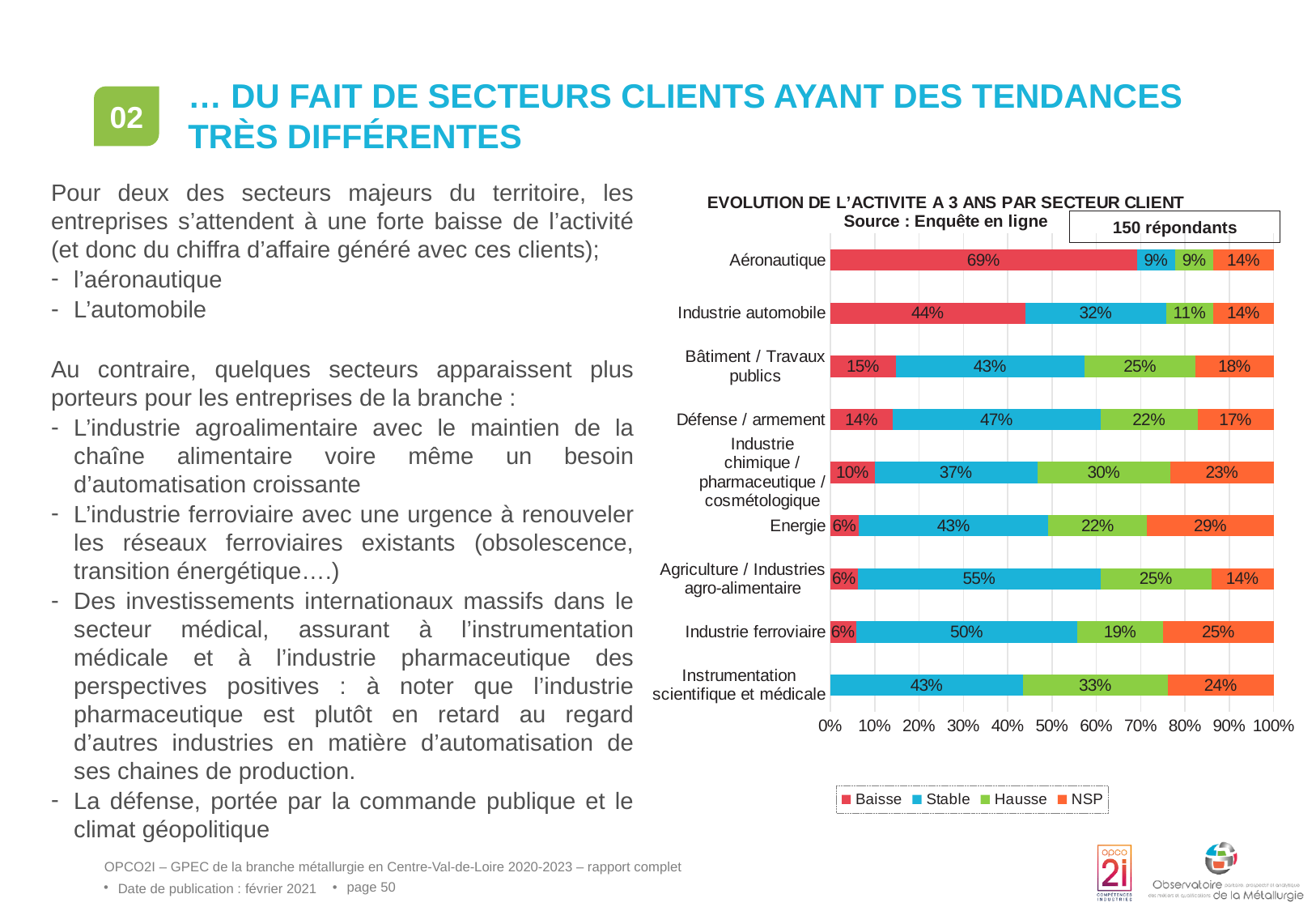
How many series does the chart legend list? 4 What is the 'NSP' value for Energie? 29% What is the 'Stable' value for Agriculture / Industries agro-alimentaire? 55% Which sector has the lowest 'Hausse' value? Aéronautique What is the 'Hausse' value for Instrumentation scientifique et médicale? 33% What is the difference between the 'Baisse' values for Aéronautique and Industrie automobile? 25% Which is larger: the 'Stable' value for Industrie ferroviaire or the 'Stable' value for Défense / armement? Industrie ferroviaire What type of chart is shown on the slide? Stacked bar chart Which sector has the highest 'Baisse' value? Aéronautique How many respondents does the chart indicate? 150 répondants How many client sectors (categories) are plotted in the chart? 9 What is the 'Baisse' value for Aéronautique? 69%